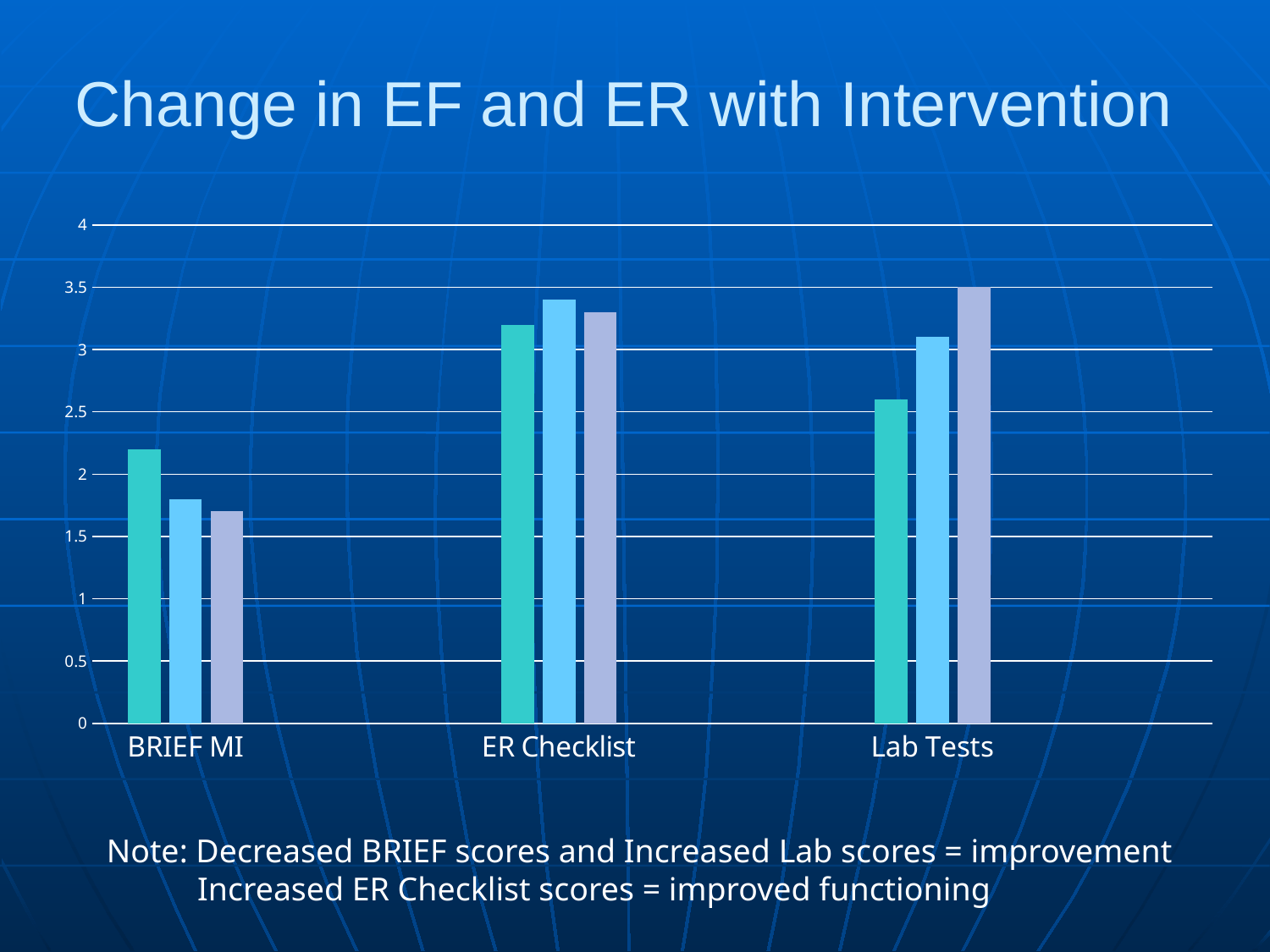
Is the value of the teal (first) bar for ER Checklist greater or less than 3? greater What is the title of the slide containing the chart? Change in EF and ER with Intervention Is the value of the teal (first) bar for BRIEF MI greater or less than 2? greater Which category has the tallest teal (first) bar? ER Checklist What kind of chart is shown on the slide? bar chart Within the Lab Tests category, do the three bars rise or fall from left to right? rise Which category has the lowest bars overall? BRIEF MI Is the value of the light blue (second) bar for BRIEF MI greater or less than 2? less How many bars are plotted for each category in the chart? 3 How many categories are shown on the x axis of the chart? 3 Which is larger: the lavender (third) bar for Lab Tests or the lavender (third) bar for BRIEF MI? Lab Tests